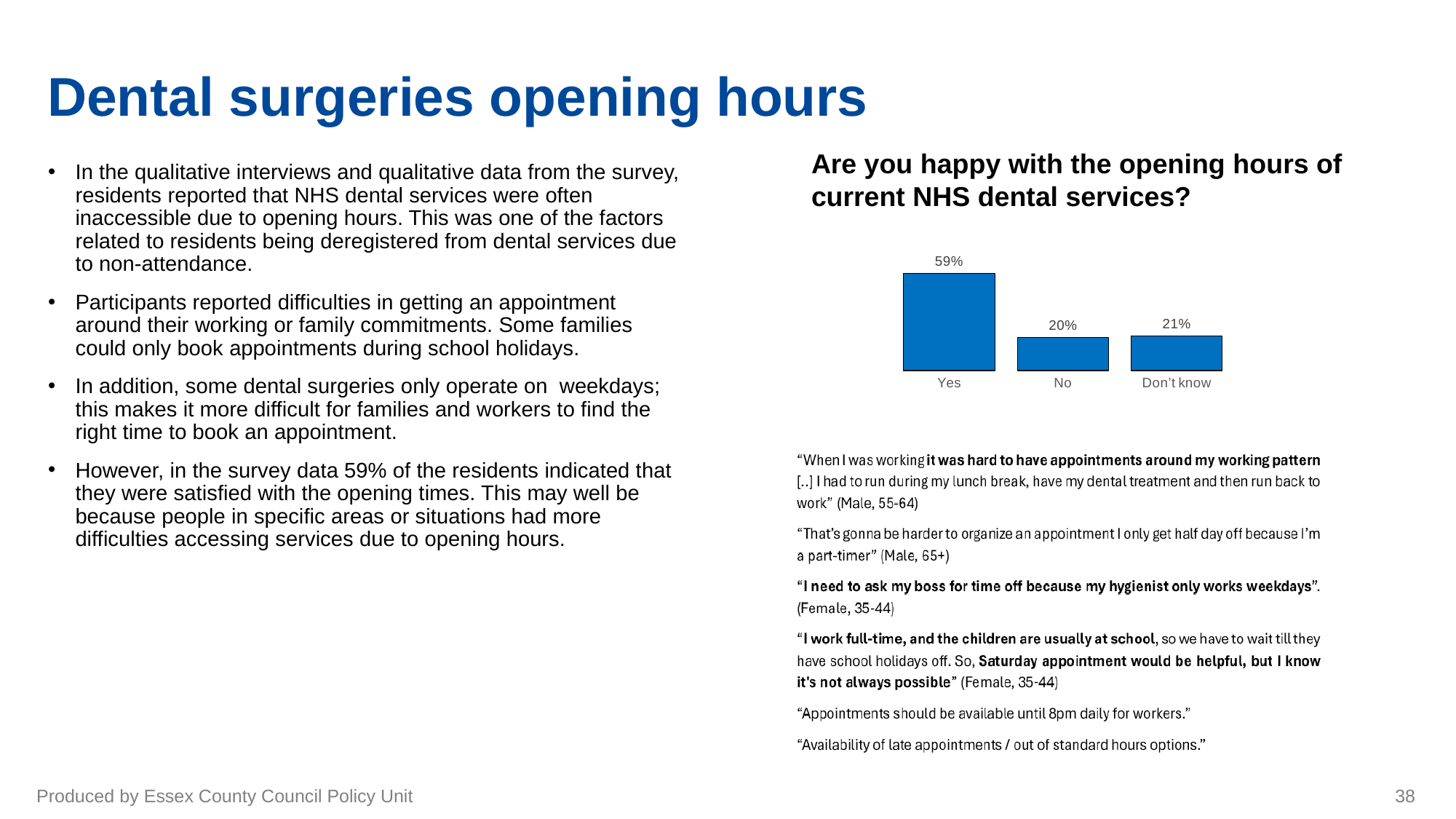
What percentage of respondents answered 'Don't know' in the chart? 21% Which response category has the highest value in the chart? Yes What is the difference in percentage points between the 'Yes' and 'No' responses? 39 percentage points What is the combined percentage of the 'No' and 'Don't know' responses? 41% Which response category has the lowest value in the chart? No What is the difference in percentage points between the 'Don't know' and 'No' responses? 1 percentage point What type of chart is used to show the responses? Bar chart What percentage of respondents answered 'No' in the chart? 20% Which is larger, the value for 'Yes' or the value for 'Don't know'? Yes How many response categories are shown in the chart? 3 What is the title of the chart? Are you happy with the opening hours of current NHS dental services? What percentage of respondents answered 'Yes' to being happy with the opening hours of current NHS dental services? 59%